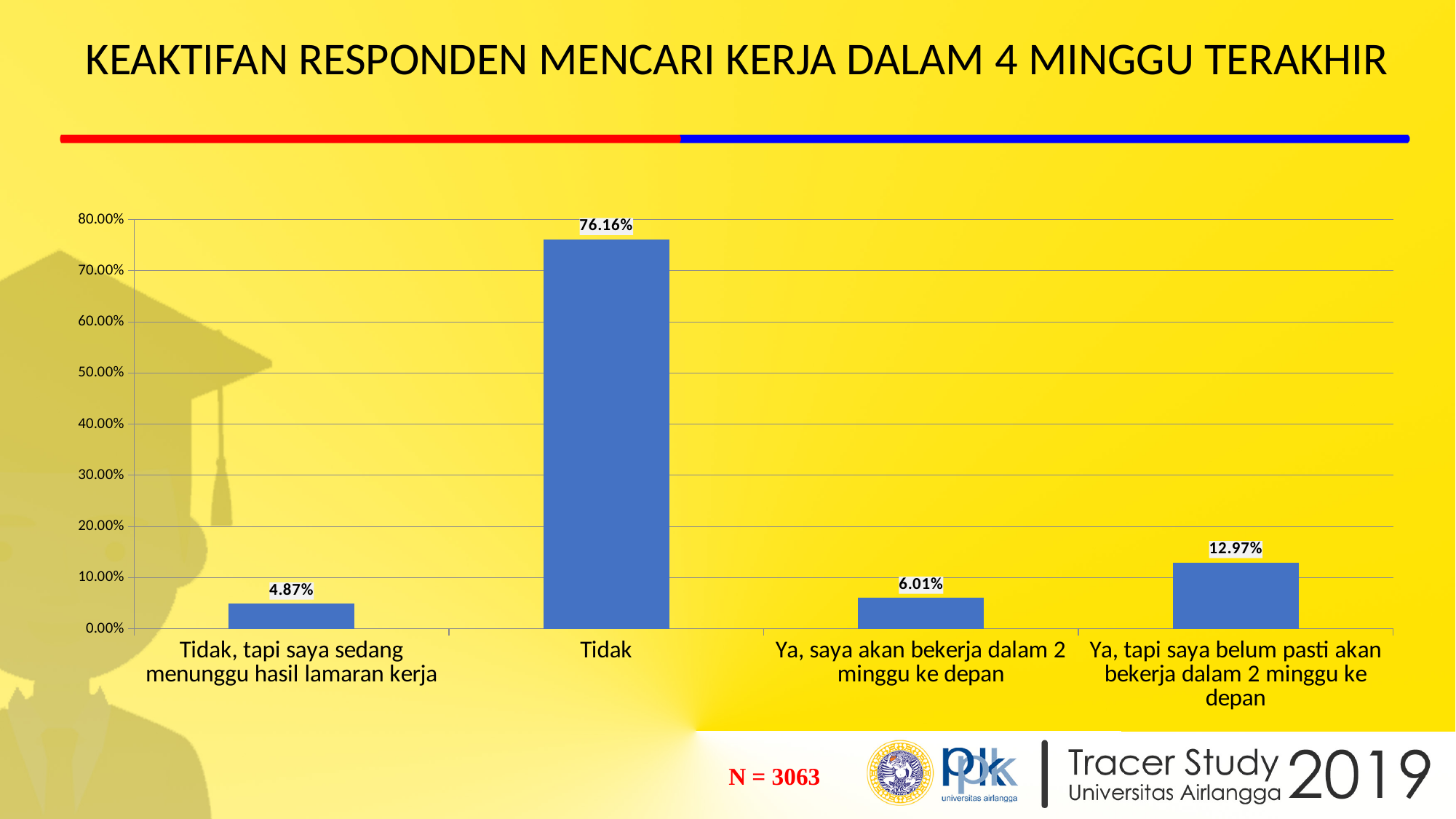
What is the value for "Ya, tapi saya belum pasti akan bekerja dalam 2 minggu ke depan"? 12.97% Is the value for "Tidak" greater or less than 70.00%? greater What is the value for "Ya, saya akan bekerja dalam 2 minggu ke depan"? 6.01% What kind of chart is shown on the slide? Bar chart Which category has the highest value? Tidak Which category has the lowest value? Tidak, tapi saya sedang menunggu hasil lamaran kerja What is the value for the category "Tidak"? 76.16% How many categories are shown on the chart? 4 Which is larger: the value for "Ya, saya akan bekerja dalam 2 minggu ke depan" or for "Ya, tapi saya belum pasti akan bekerja dalam 2 minggu ke depan"? Ya, tapi saya belum pasti akan bekerja dalam 2 minggu ke depan What is the difference between the values for "Tidak" and "Ya, tapi saya belum pasti akan bekerja dalam 2 minggu ke depan"? 63.19% What is the title of the slide? KEAKTIFAN RESPONDEN MENCARI KERJA DALAM 4 MINGGU TERAKHIR What is the value for "Tidak, tapi saya sedang menunggu hasil lamaran kerja"? 4.87%